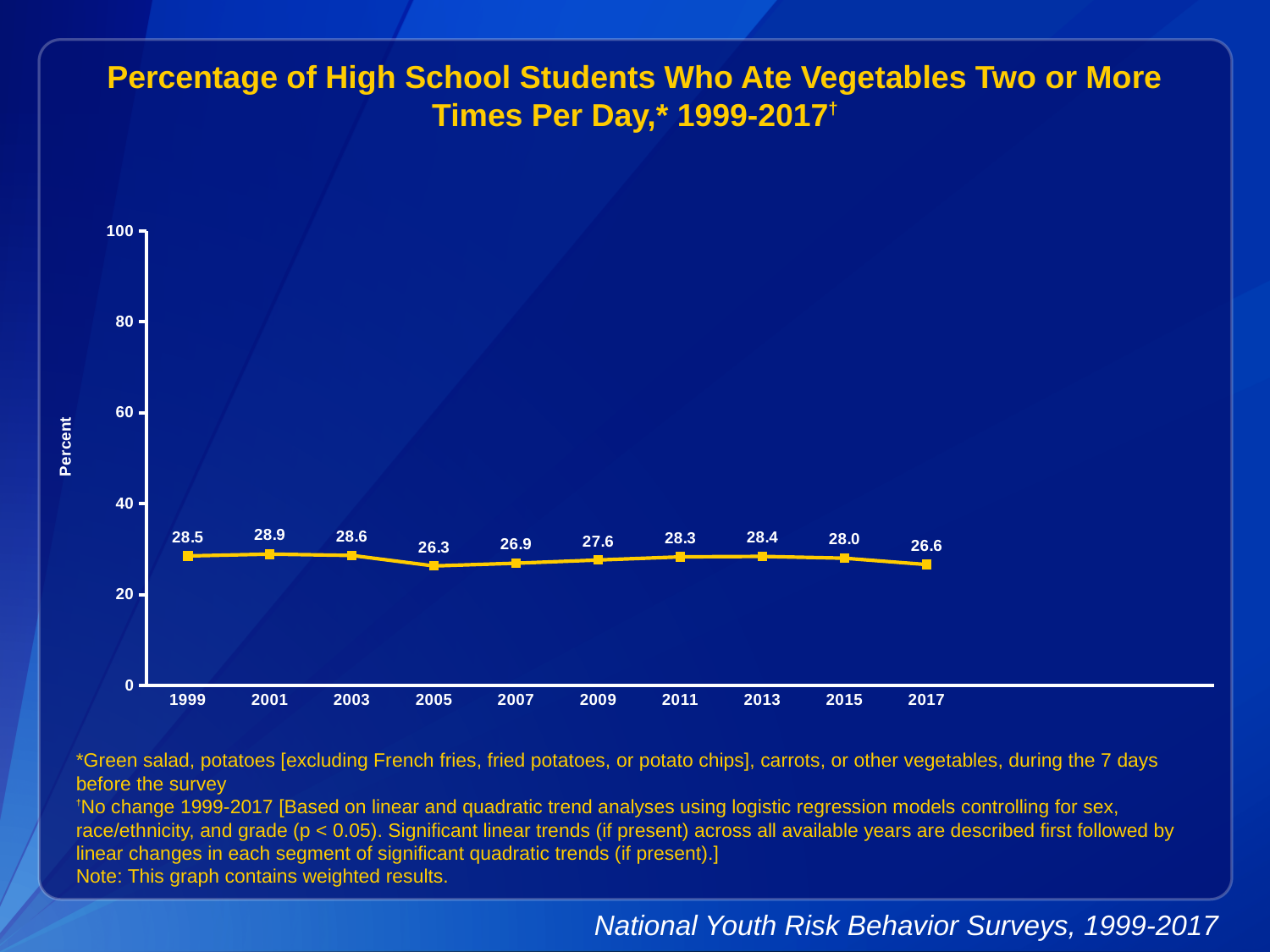
What is the difference between the values for 1999 and 2017? 1.9 What is the value for 1999? 28.5 What is the difference between the values for 2001 and 2005? 2.6 How many years are plotted on the chart? 10 Which year has the lowest value? 2005 What is the value for 2005? 26.3 Which year has the highest value? 2001 What is the label on the y axis? Percent What is the value for 2017? 26.6 Which is larger, the value for 2009 or the value for 2015? 2015 Is the value for 2013 greater or less than 40? less What kind of chart is shown on the slide? line chart